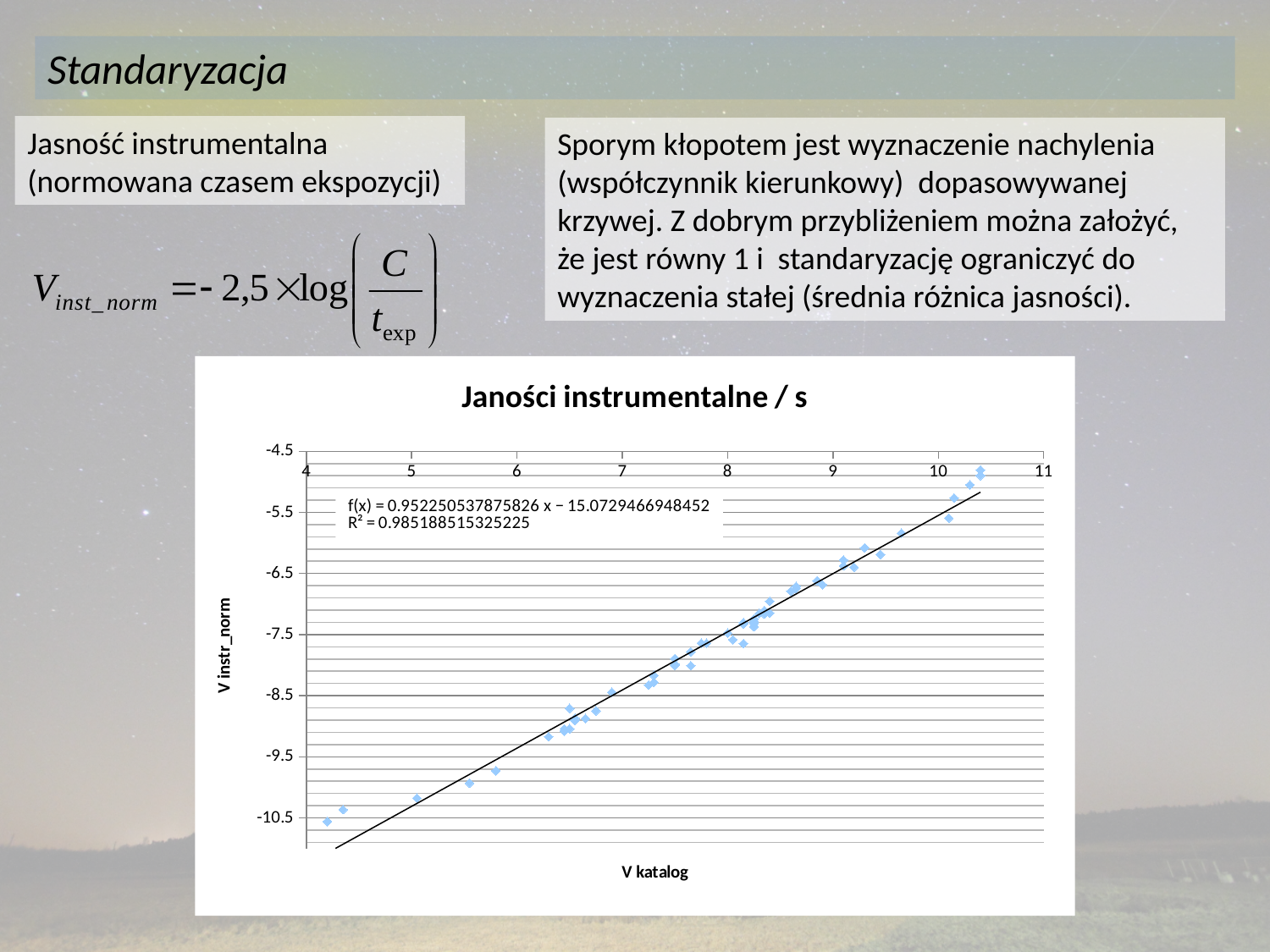
What kind of chart is shown on the slide? scatter chart What is the label of the horizontal axis of the chart? V katalog Is the V instr_norm value of the point with the smallest V katalog (around 4.2) greater or less than -9.5? less What is the title of the chart? Janości instrumentalne / s What is the intercept of the fitted line f(x) shown on the chart? −15.0729466948452 What is the lowest value shown on the vertical axis of the chart? -10.5 What is the R² value shown on the chart? 0.985188515325225 Is the V instr_norm value of the point with the largest V katalog (around 10.4) greater or less than -5.5? greater As V katalog increases along the x axis, do the V instr_norm values rise or fall? rise What is the slope of the fitted line f(x) shown on the chart? 0.952250537875826